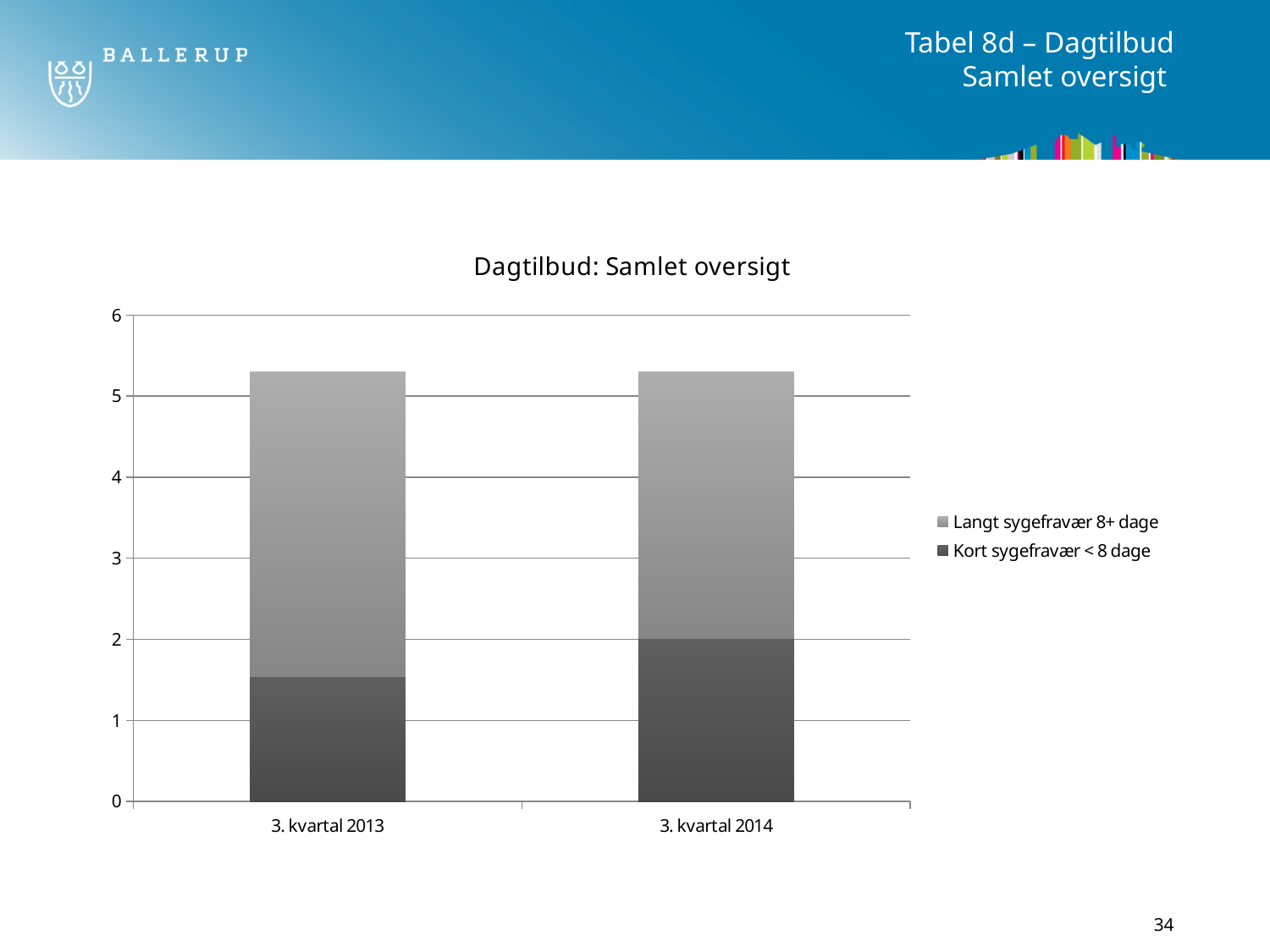
Which quarter has the larger value for Kort sygefravær < 8 dage, 3. kvartal 2013 or 3. kvartal 2014? 3. kvartal 2014 Is the value for Kort sygefravær < 8 dage in 3. kvartal 2013 greater or less than 1? greater Is the total height of the bar for 3. kvartal 2014 greater or less than 5? greater What is the title of the chart? Dagtilbud: Samlet oversigt Does the value for Kort sygefravær < 8 dage rise or fall from 3. kvartal 2013 to 3. kvartal 2014? rise Is the total height of the bar for 3. kvartal 2013 greater or less than 5? greater How many series does the chart's legend list? 2 Which quarter has the larger value for Langt sygefravær 8+ dage, 3. kvartal 2013 or 3. kvartal 2014? 3. kvartal 2013 How many categories are shown on the x axis of the chart? 2 What kind of chart is shown on the slide? Stacked bar chart Which series is shown in the darker colour at the bottom of each bar? Kort sygefravær < 8 dage